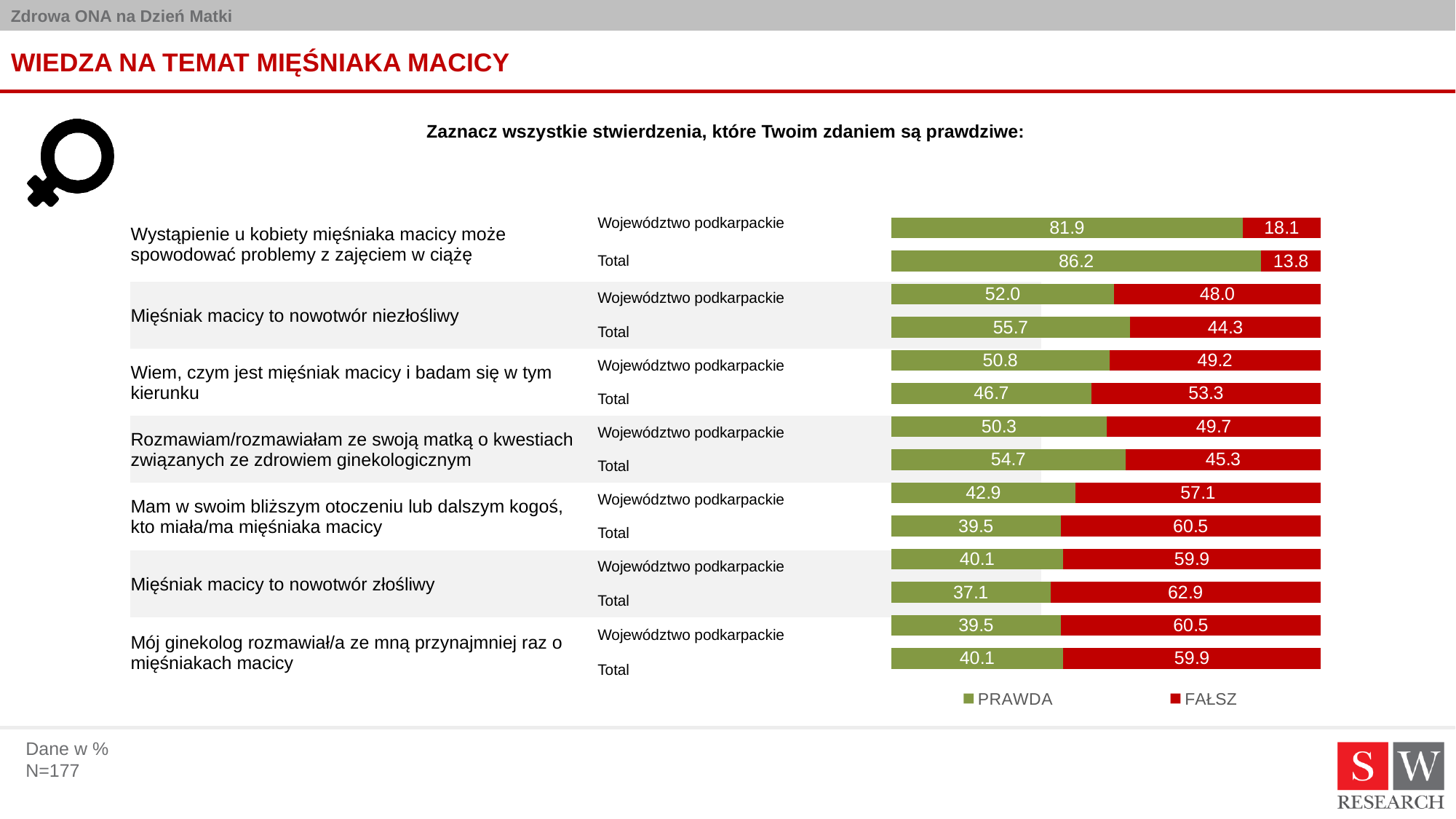
Which colour represents FAŁSZ in the chart? Red What is the difference between the PRAWDA values for Total and Województwo podkarpackie for the statement "Mięśniak macicy to nowotwór niezłośliwy"? 3.7 What type of chart is shown on the slide? Stacked bar chart What is the PRAWDA value for Województwo podkarpackie for the statement "Wystąpienie u kobiety mięśniaka macicy może spowodować problemy z zajęciem w ciążę"? 81.9 For the statement "Wiem, czym jest mięśniak macicy i badam się w tym kierunku", which has the larger PRAWDA value: Województwo podkarpackie or Total? Województwo podkarpackie What is the total of the stacked bar for Województwo podkarpackie for the statement "Mam w swoim bliższym otoczeniu lub dalszym kogoś, kto miała/ma mięśniaka macicy"? 100.0 Which bar has the highest PRAWDA value? Total for "Wystąpienie u kobiety mięśniaka macicy może spowodować problemy z zajęciem w ciążę" (86.2) How many series does the legend list? 2 What is the PRAWDA value for Total for the statement "Rozmawiam/rozmawiałam ze swoją matką o kwestiach związanych ze zdrowiem ginekologicznym"? 54.7 How many statements are shown in the chart? 7 Which bar has the lowest PRAWDA value? Total for "Mięśniak macicy to nowotwór złośliwy" (37.1) What is the FAŁSZ value for Total for the statement "Mięśniak macicy to nowotwór złośliwy"? 62.9